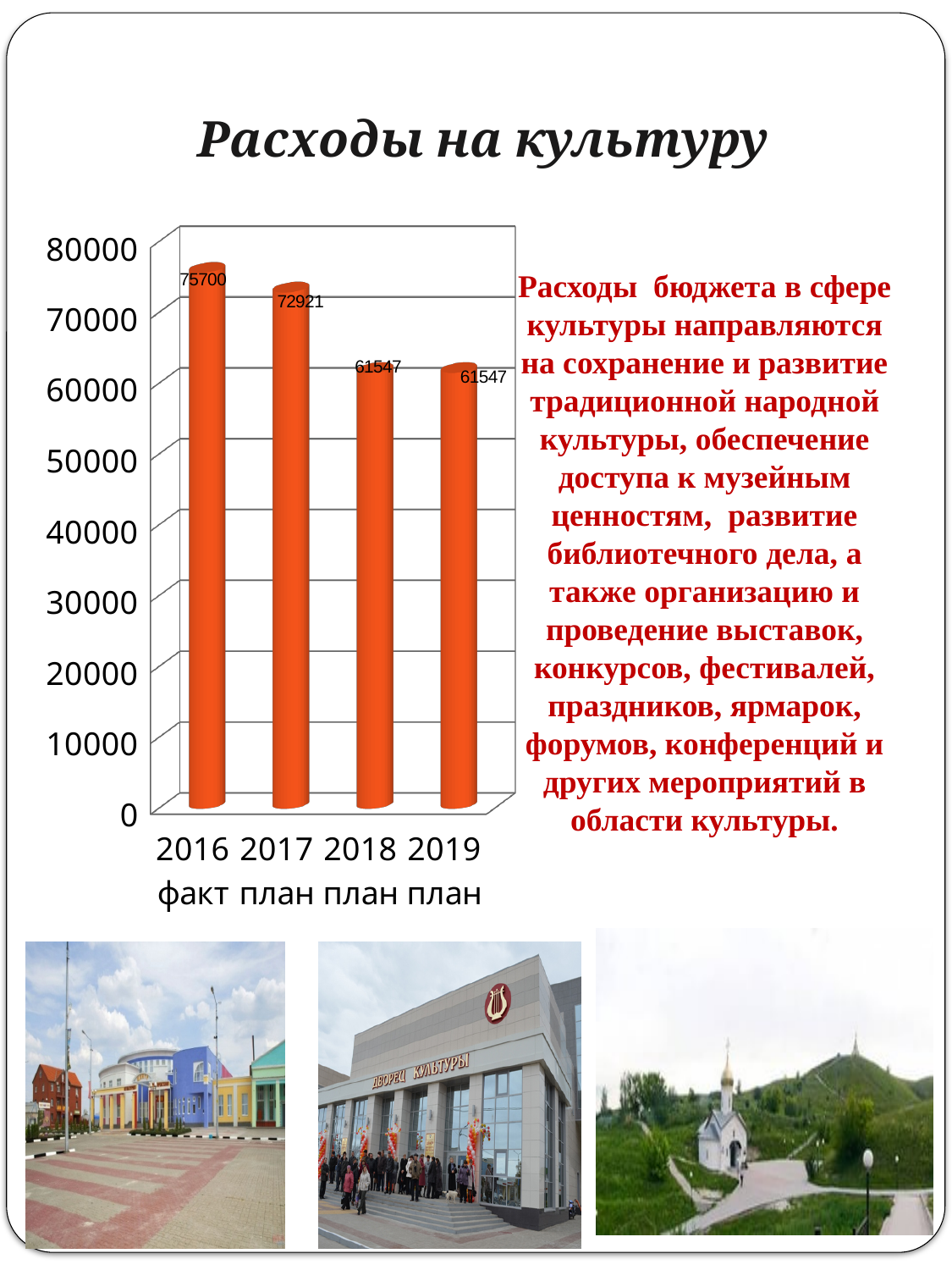
What is the title of the chart? Расходы на культуру What is the difference between the values for 2016 факт and 2017 план? 2779 Which is larger, the value for 2017 план or the value for 2019 план? 2017 план What is the value for 2016 факт? 75700 What is the difference between the values for 2017 план and 2018 план? 11374 What is the value for 2017 план? 72921 Is the value for 2018 план greater or less than 70000? less How many categories are shown on the x axis? 4 What kind of chart is shown on the slide? bar chart What is the value for 2019 план? 61547 Which category has the highest value? 2016 факт What is the value for 2018 план? 61547